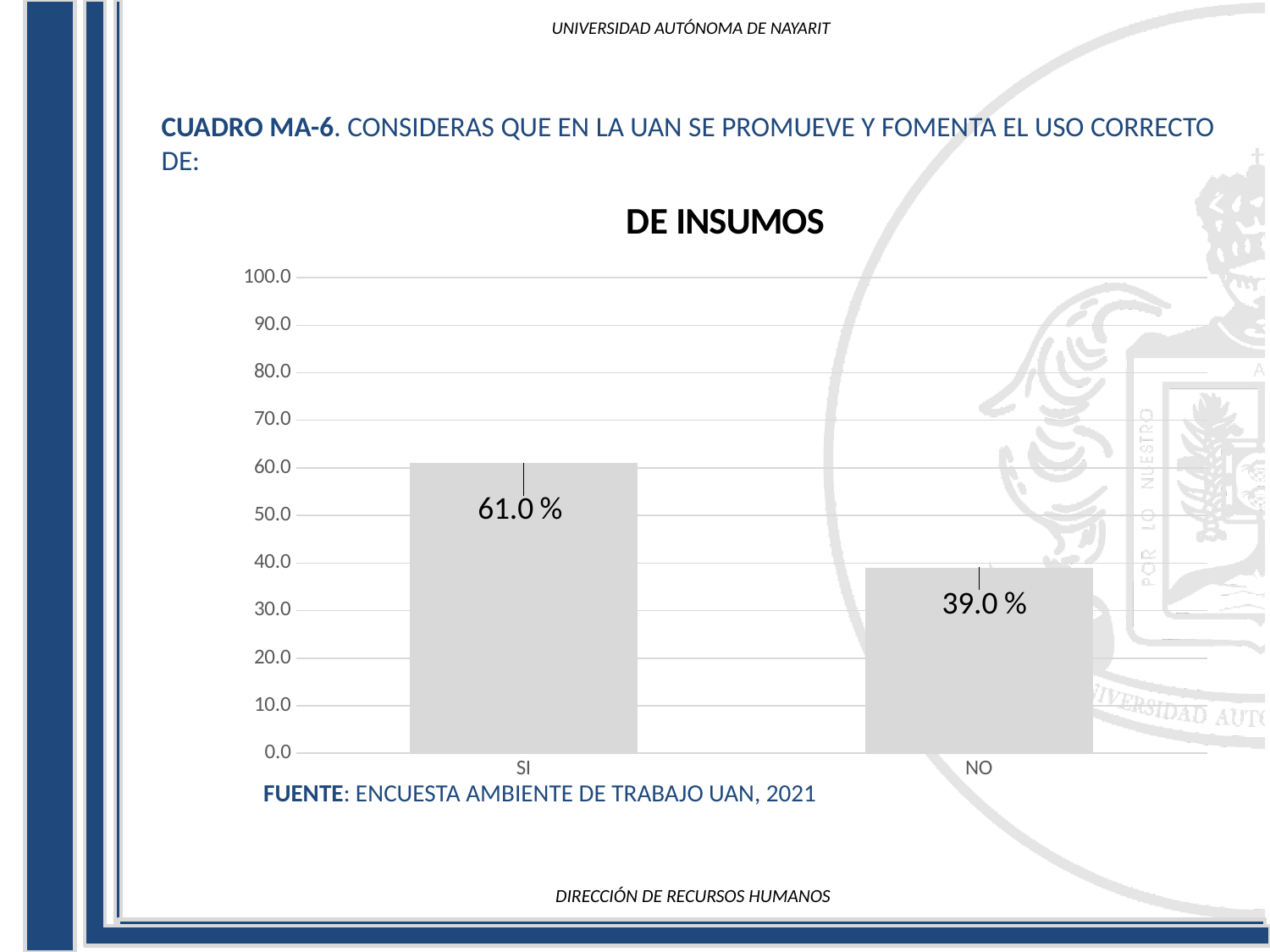
What is the value for NO? 39.0 % Which category has the lowest value? NO What is the value for SI? 61.0 % Is the value for SI greater or less than 60.0? greater What kind of chart is shown? bar chart What is the title of the chart? DE INSUMOS What is the highest value shown on the y axis? 100.0 Is the value for NO greater or less than 50.0? less What is the difference between the values for SI and NO? 22.0 % How many categories are shown on the x axis? 2 Which is larger, the value for SI or the value for NO? SI Which category has the highest value? SI